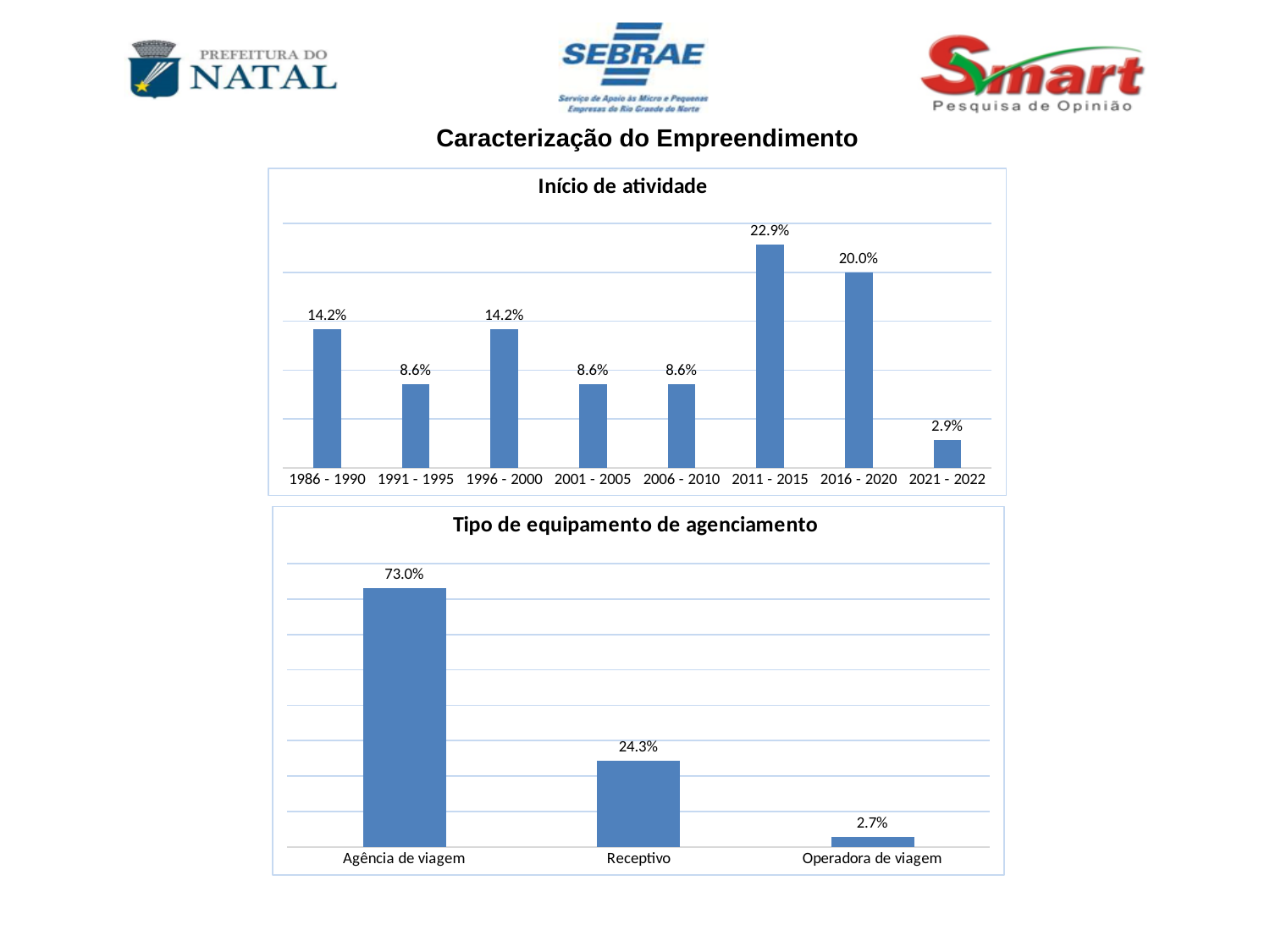
In the 'Tipo de equipamento de agenciamento' chart, which category has the highest value? Agência de viagem In the 'Tipo de equipamento de agenciamento' chart, what is the value for Receptivo? 24.3% In the 'Início de atividade' chart, which period has the lowest value? 2021 - 2022 In the 'Início de atividade' chart, which is larger, the value for 1986 - 1990 or the value for 1991 - 1995? 1986 - 1990 How many categories are shown in the 'Tipo de equipamento de agenciamento' chart? 3 In the 'Tipo de equipamento de agenciamento' chart, what is the difference between Agência de viagem and Receptivo? 48.7% In the 'Início de atividade' chart, what is the value for 2021 - 2022? 2.9% How many periods are shown in the 'Início de atividade' chart? 8 In the 'Início de atividade' chart, what is the difference between the values for 2011 - 2015 and 2016 - 2020? 2.9% What type of chart is the 'Tipo de equipamento de agenciamento' chart? Bar chart In the 'Início de atividade' chart, what is the value for 2011 - 2015? 22.9% In the 'Início de atividade' chart, which period has the highest value? 2011 - 2015